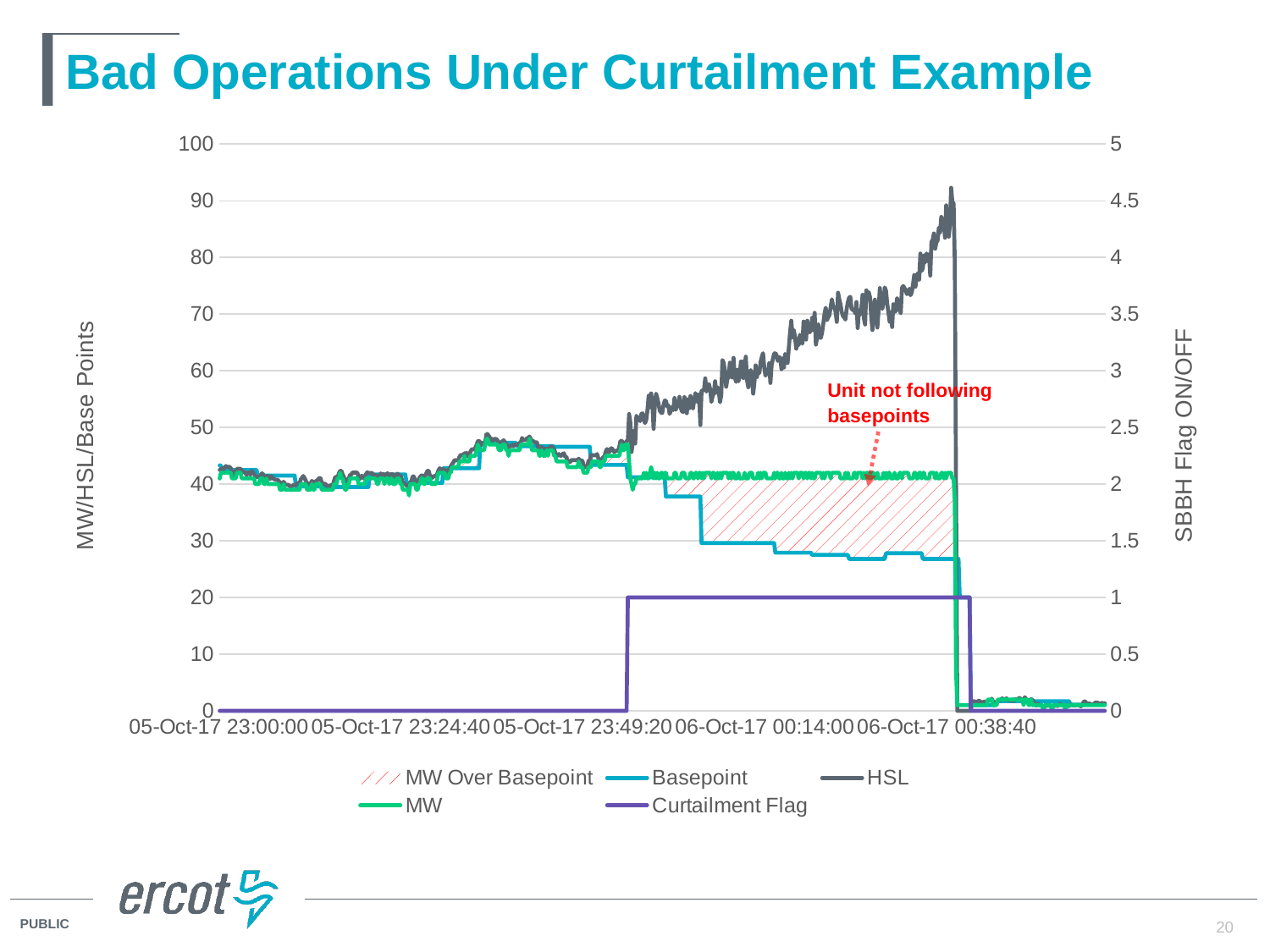
Is the Basepoint value around 06-Oct-17 00:14:00 greater or less than 40? less How many series does the legend list? 5 What kind of chart is shown on the slide? line chart What is the value of the Curtailment Flag at the start of the chart (05-Oct-17 23:00:00)? 0 What value on the right axis does the Curtailment Flag line reach while the curtailment is active? 1 Is the peak value of the HSL line greater or less than 80? greater What is the label of the right-hand vertical axis? SBBH Flag ON/OFF How many time labels are shown along the x axis? 5 Is the MW value around 06-Oct-17 00:14:00 greater or less than 50? less Around 06-Oct-17 00:14:00, which is larger, the MW value or the Basepoint value? MW Between 05-Oct-17 23:49:20 and 06-Oct-17 00:38:40, does the HSL line generally rise or fall? rise What is the title of the chart on the slide? Bad Operations Under Curtailment Example